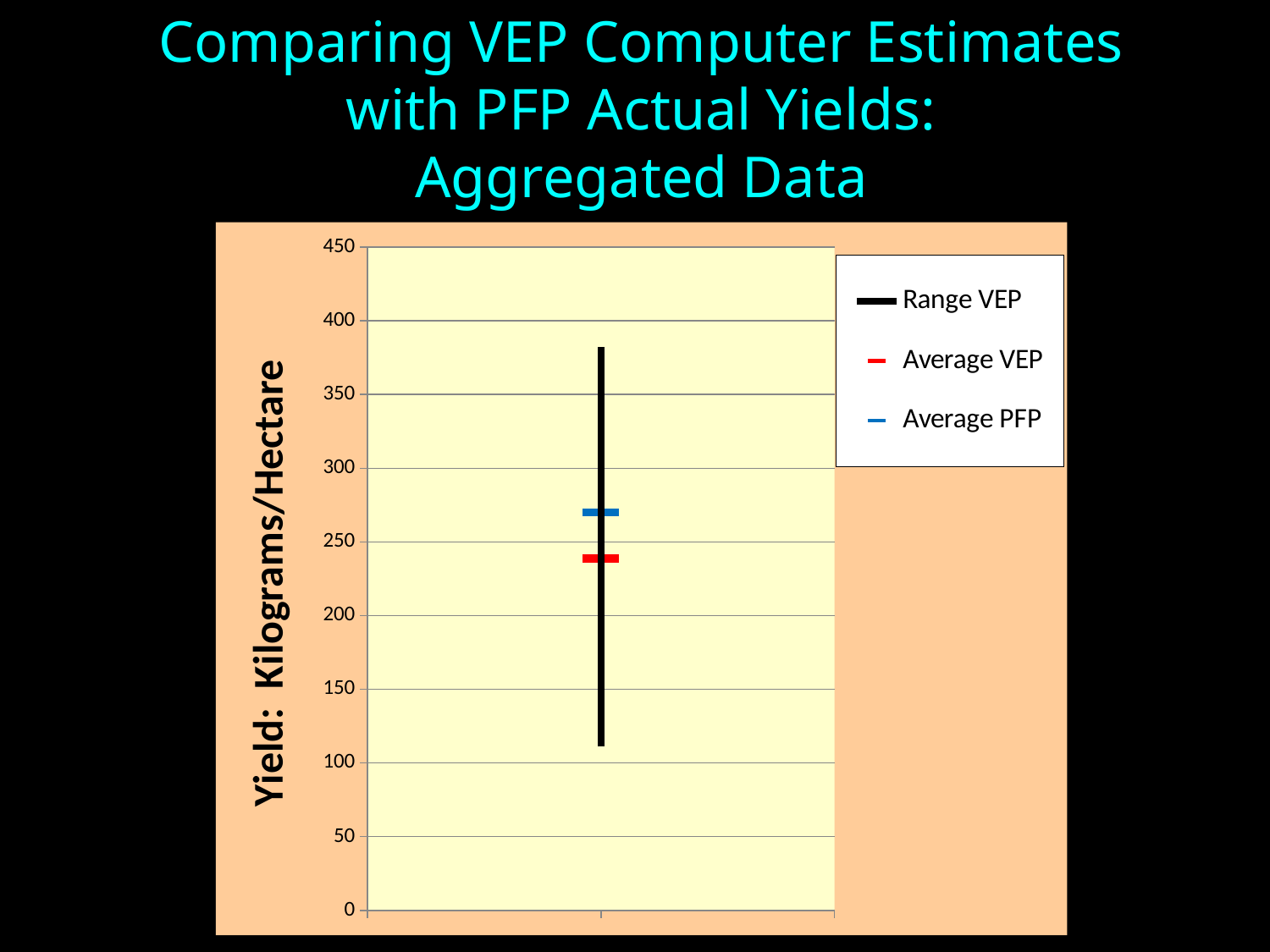
Is the value for Average PFP greater or less than 300? less How many categories are plotted on the x axis? 1 Which is larger, Average PFP or Average VEP? Average PFP Is the value for Average VEP greater or less than 250? less Is the value for Average VEP greater or less than 200? greater What is the highest value shown on the y axis? 450 Which series is shown in blue in the legend? Average PFP How many series does the legend list? 3 Which series is shown in red in the legend? Average VEP